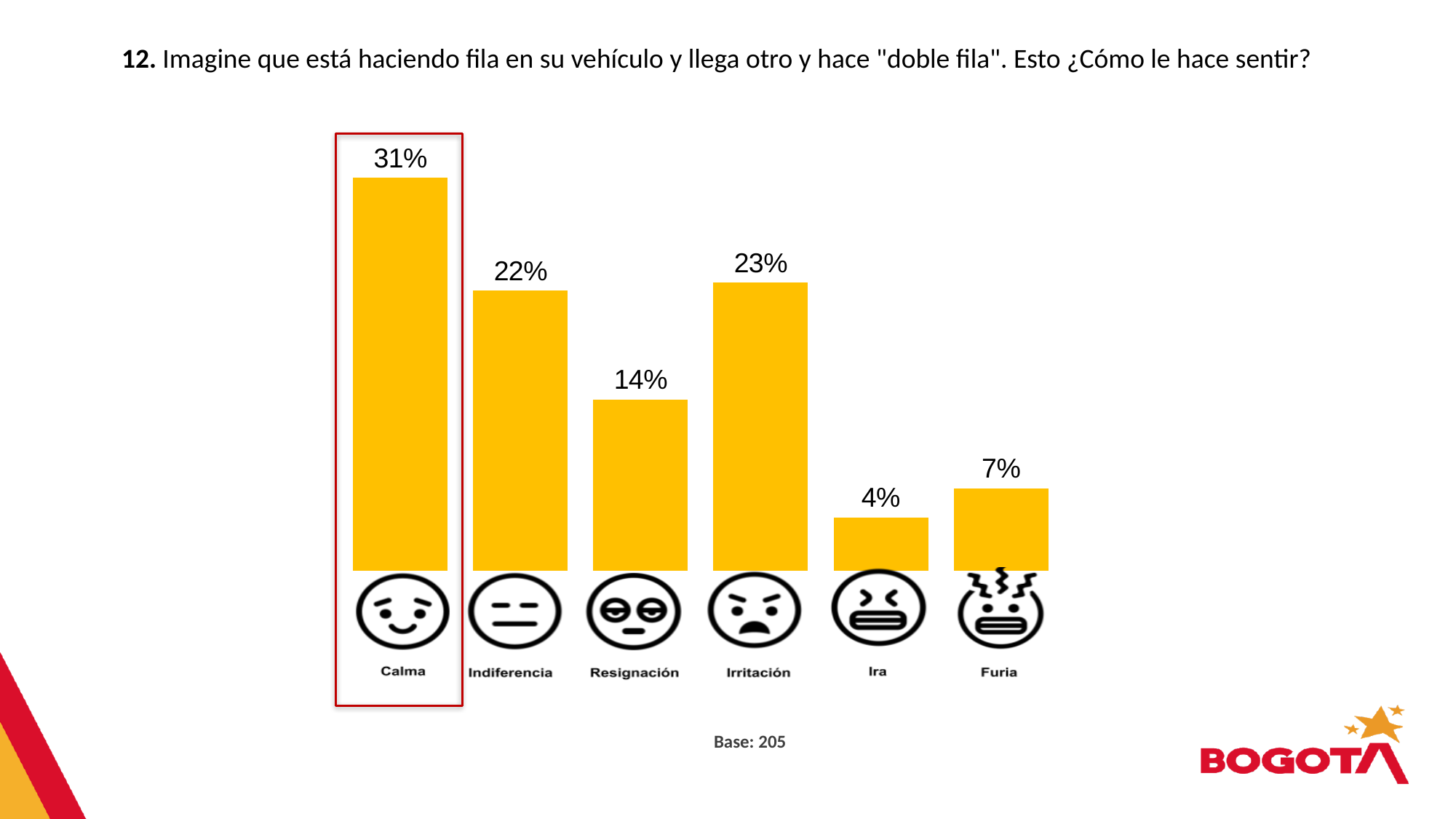
What is the base (number of respondents) shown below the chart? 205 Which category has the highest value? Calma Which category has the lowest value? Ira What is the value shown for Ira? 4% What percentage of respondents answered Calma? 31% What kind of chart is shown on the slide? Bar chart Which is larger, the value for Irritación or the value for Resignación? Irritación Which category is highlighted with a red box? Calma How many categories are shown in the chart? 6 What is the difference between the values for Calma and Indiferencia? 9% What is the value shown for Resignación? 14% What is the difference between the values for Furia and Ira? 3%